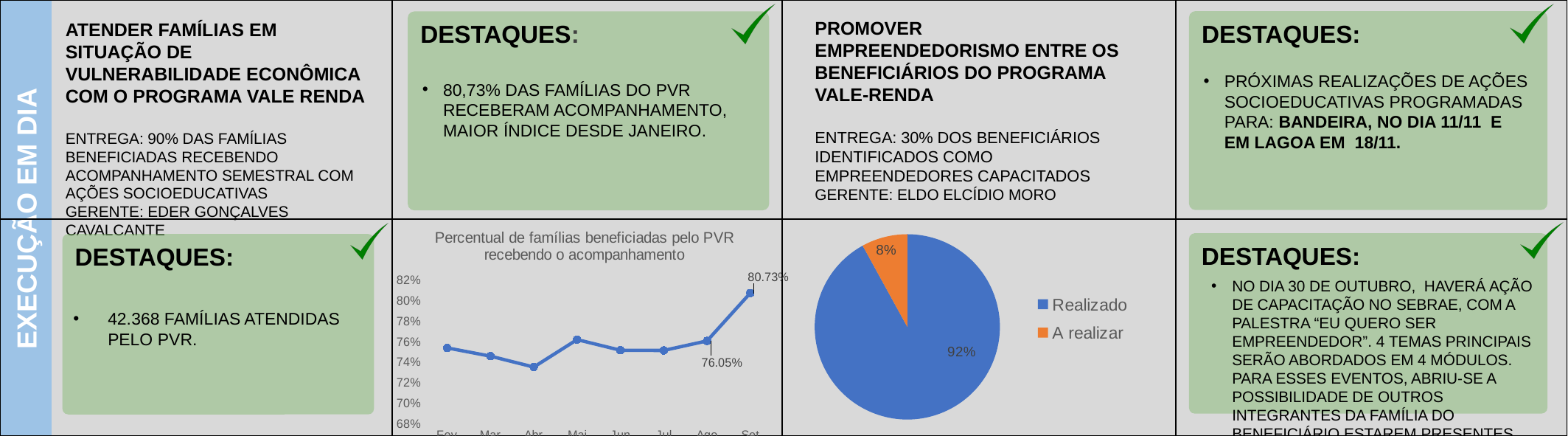
On the pie chart in the lower middle of the slide, what share is 'A realizar'? 8% On the pie chart in the lower middle of the slide, how many entries does the legend list? 2 On the line chart titled 'Percentual de famílias beneficiadas pelo PVR recebendo o acompanhamento', how many months are plotted? 8 On the line chart titled 'Percentual de famílias beneficiadas pelo PVR recebendo o acompanhamento', what type of chart is used? line chart On the line chart titled 'Percentual de famílias beneficiadas pelo PVR recebendo o acompanhamento', what is the value for Set? 80.73% On the line chart titled 'Percentual de famílias beneficiadas pelo PVR recebendo o acompanhamento', what is the value for Ago? 76.05% On the line chart titled 'Percentual de famílias beneficiadas pelo PVR recebendo o acompanhamento', which month has the lowest value? Abr On the line chart titled 'Percentual de famílias beneficiadas pelo PVR recebendo o acompanhamento', is the value for Abr greater or less than 74%? less On the line chart titled 'Percentual de famílias beneficiadas pelo PVR recebendo o acompanhamento', does the value rise or fall from Ago to Set? rise On the line chart titled 'Percentual de famílias beneficiadas pelo PVR recebendo o acompanhamento', which month has the highest value? Set On the pie chart in the lower middle of the slide, what share is 'Realizado'? 92%